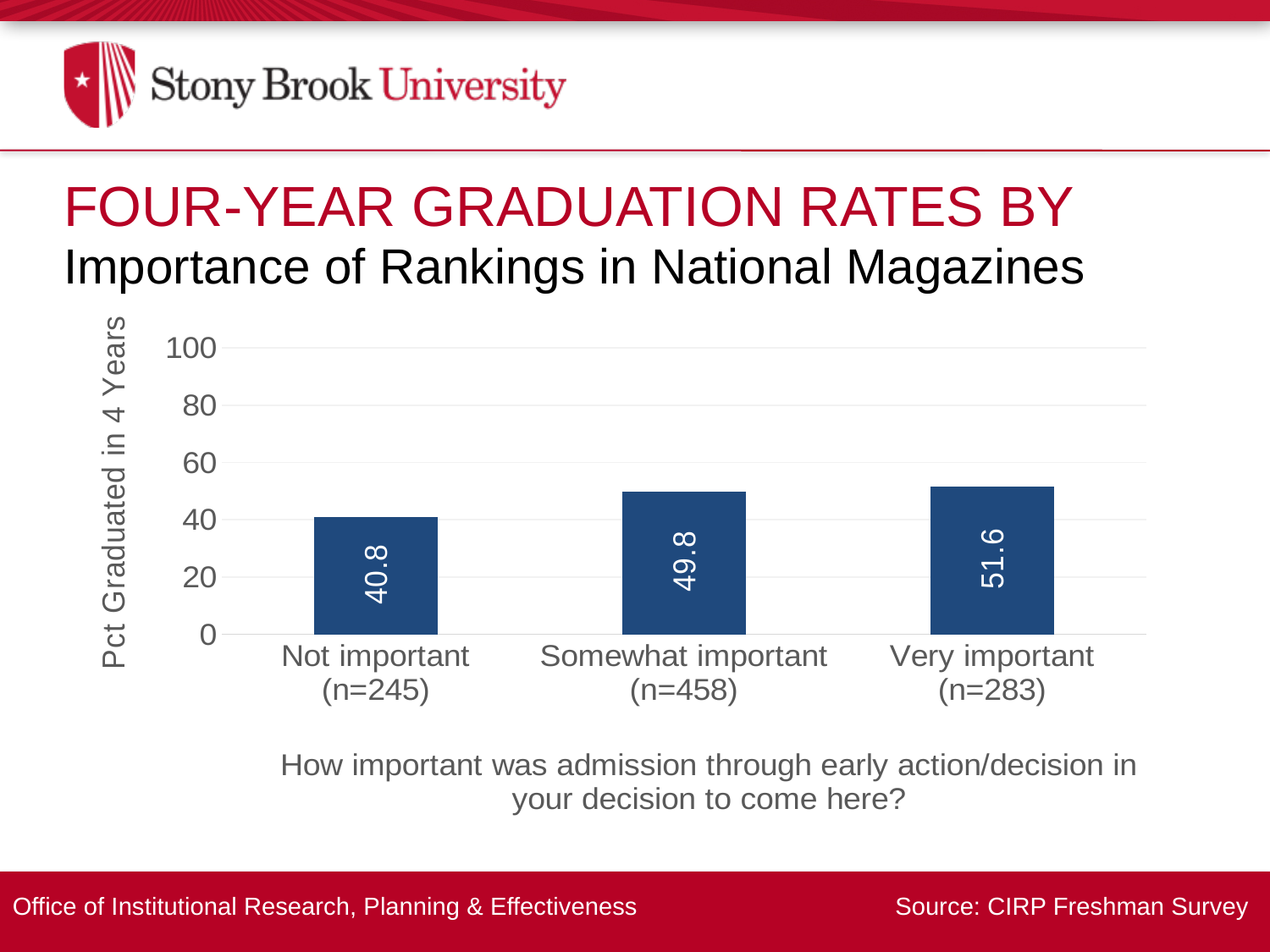
Which category has the highest four-year graduation rate? Very important What is the four-year graduation rate for the Very important group? 51.6 What is the four-year graduation rate for the Somewhat important group? 49.8 What type of chart is shown on the slide? Bar chart Which group has a higher graduation rate, Not important or Somewhat important? Somewhat important What is the four-year graduation rate for students who said rankings were Not important? 40.8 What is the label of the vertical axis? Pct Graduated in 4 Years What is the difference in graduation rate between the Somewhat important and Not important groups? 9.0 What is the difference in graduation rate between the Very important and Not important groups? 10.8 How many categories are shown on the x axis? 3 Is the graduation rate for the Very important group greater or less than 60? less Which category has the lowest four-year graduation rate? Not important